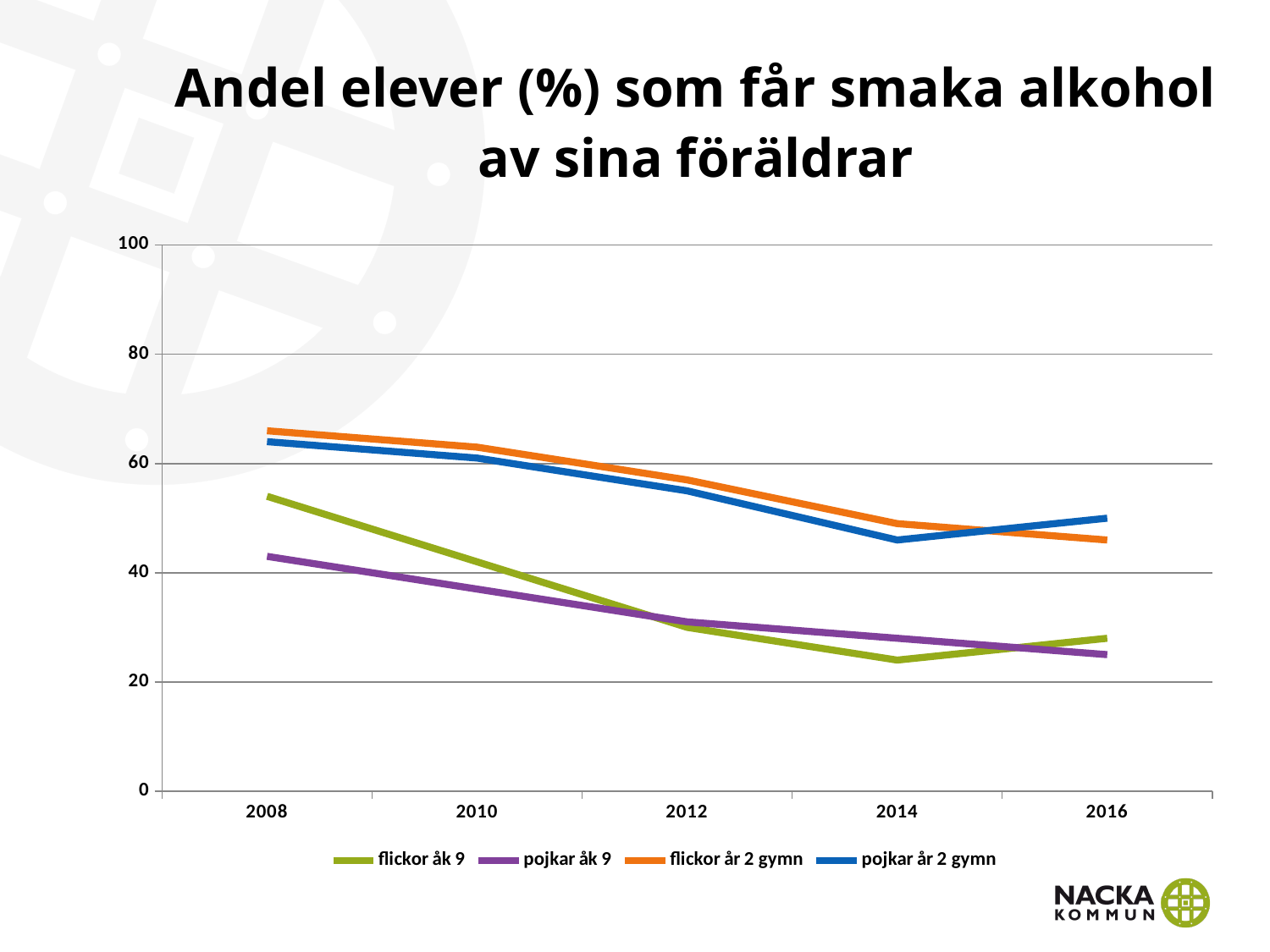
Is the value for pojkar år 2 gymn in 2014 greater or less than 60? less Does the value for flickor år 2 gymn rise or fall from 2008 to 2016? fall Which series has the lowest value in 2008? pojkar åk 9 How many series does the legend list? 4 What kind of chart is shown on the slide? line chart In 2016, which is higher: pojkar år 2 gymn or flickor år 2 gymn? pojkar år 2 gymn In 2008, which is higher: flickor åk 9 or pojkar åk 9? flickor åk 9 How many years are shown on the x axis? 5 Is the value for flickor år 2 gymn in 2008 greater or less than 60? greater Is the value for flickor åk 9 in 2014 greater or less than 20? greater What colour is the line for pojkar år 2 gymn? blue